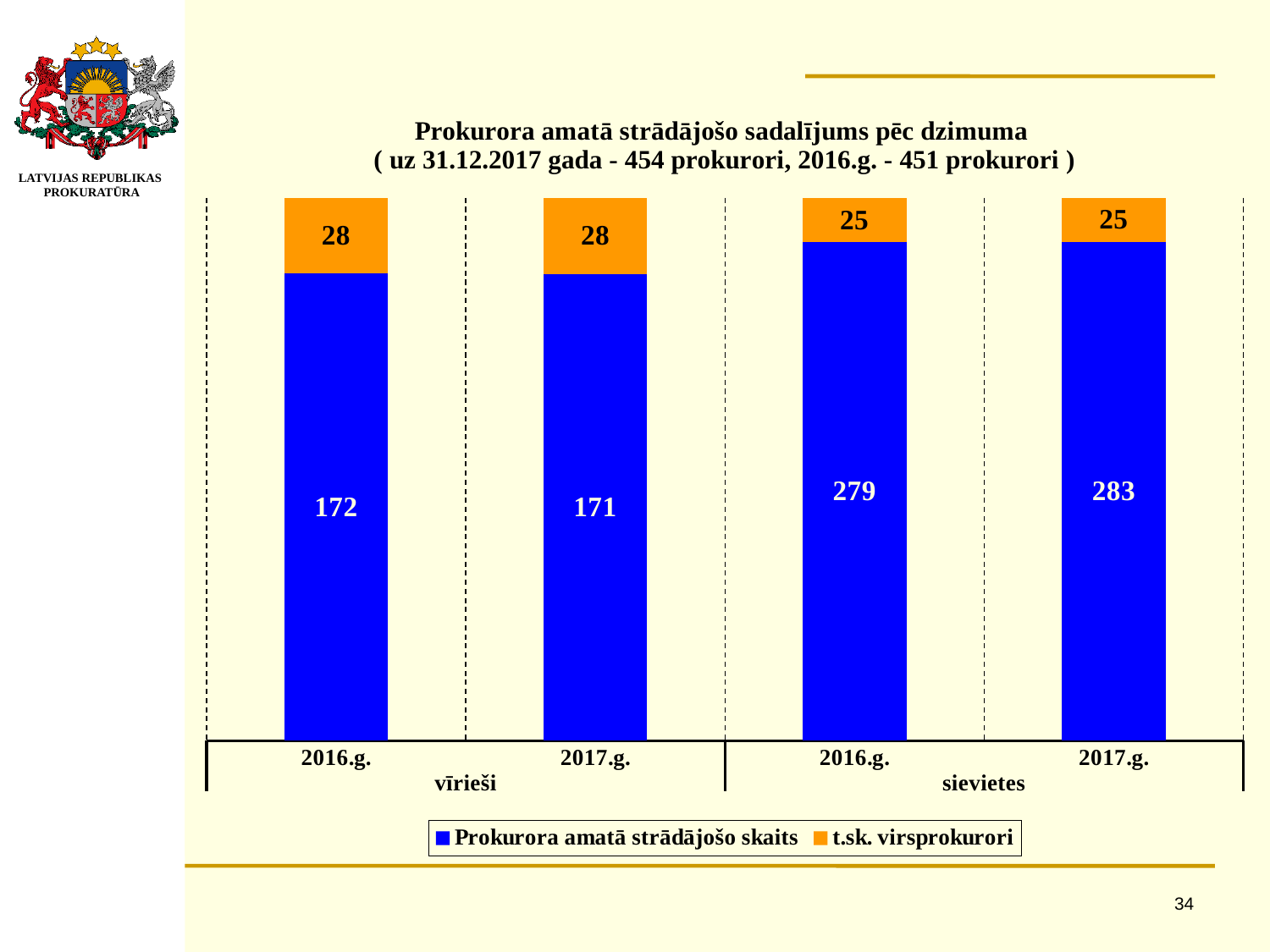
Which is larger: the 't.sk. virsprokurori' value for vīrieši in 2017.g. or for sievietes in 2017.g.? vīrieši 2017.g. What is the difference between the 'Prokurora amatā strādājošo skaits' values for sievietes in 2017.g. and vīrieši in 2017.g.? 112 Which bar has the highest value for 'Prokurora amatā strādājošo skaits'? sievietes 2017.g. What is the value of 'Prokurora amatā strādājošo skaits' for vīrieši in 2016.g.? 172 What kind of chart is shown on the slide? stacked bar chart Which bar has the lowest value for 'Prokurora amatā strādājošo skaits'? vīrieši 2017.g. What is the value of 'Prokurora amatā strādājošo skaits' for sievietes in 2016.g.? 279 What is the value of 't.sk. virsprokurori' for vīrieši in 2016.g.? 28 What is the value of 'Prokurora amatā strādājošo skaits' for sievietes in 2017.g.? 283 What is the value of 't.sk. virsprokurori' for sievietes in 2017.g.? 25 What is the value of 'Prokurora amatā strādājošo skaits' for vīrieši in 2017.g.? 171 How many series does the legend list? 2